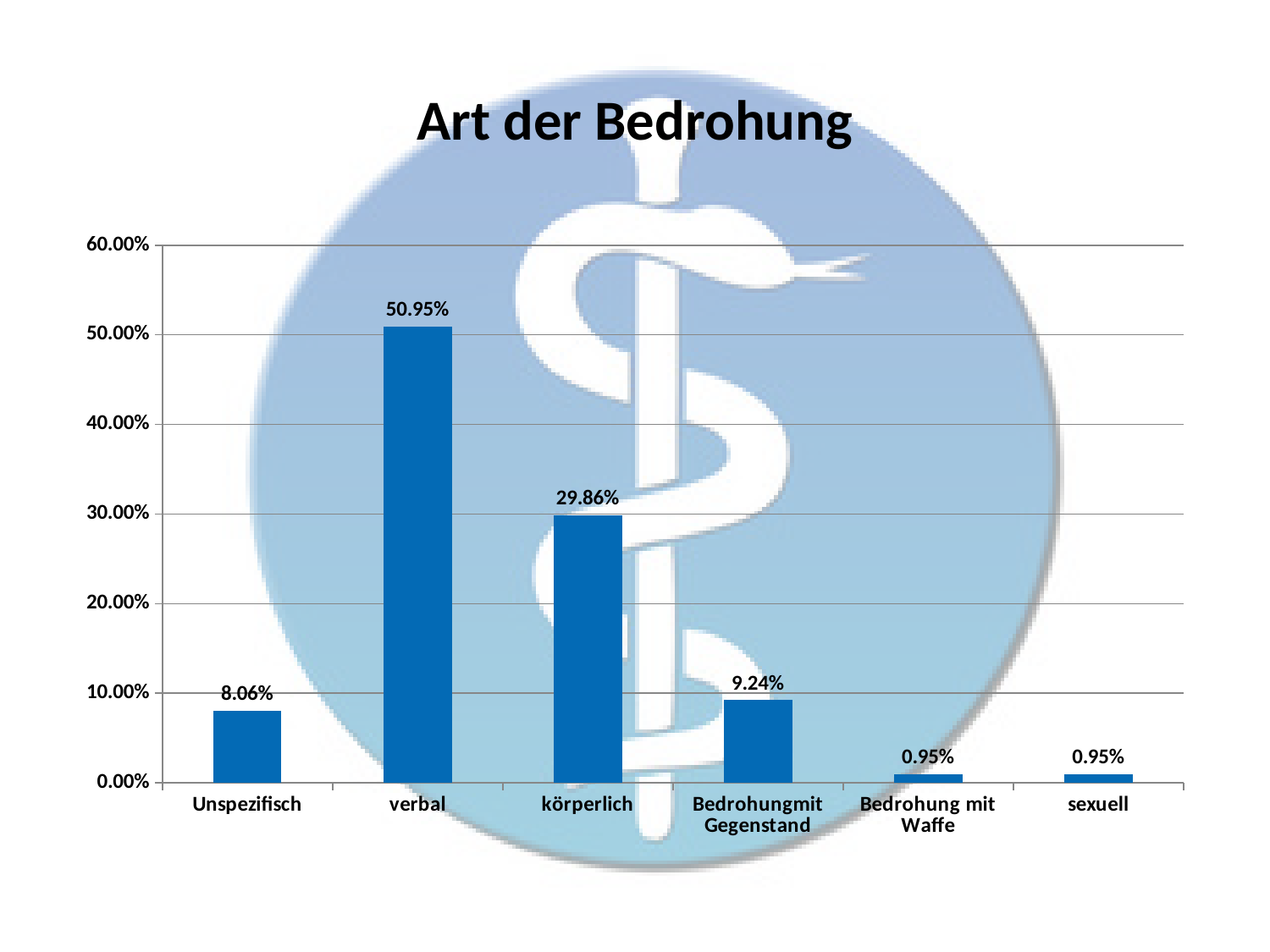
What is the value for körperlich? 29.86% How many categories are shown on the x axis? 6 Which category has the highest value? verbal What is the value for verbal? 50.95% What is the value for Bedrohung mit Gegenstand? 9.24% Which is larger, the value for Unspezifisch or the value for Bedrohung mit Gegenstand? Bedrohung mit Gegenstand What is the difference between the values for verbal and körperlich? 21.09% What is the title of the chart? Art der Bedrohung What is the value for sexuell? 0.95% What kind of chart is shown on the slide? bar chart Is the value for körperlich greater or less than 20.00%? greater What is the value for Unspezifisch? 8.06%